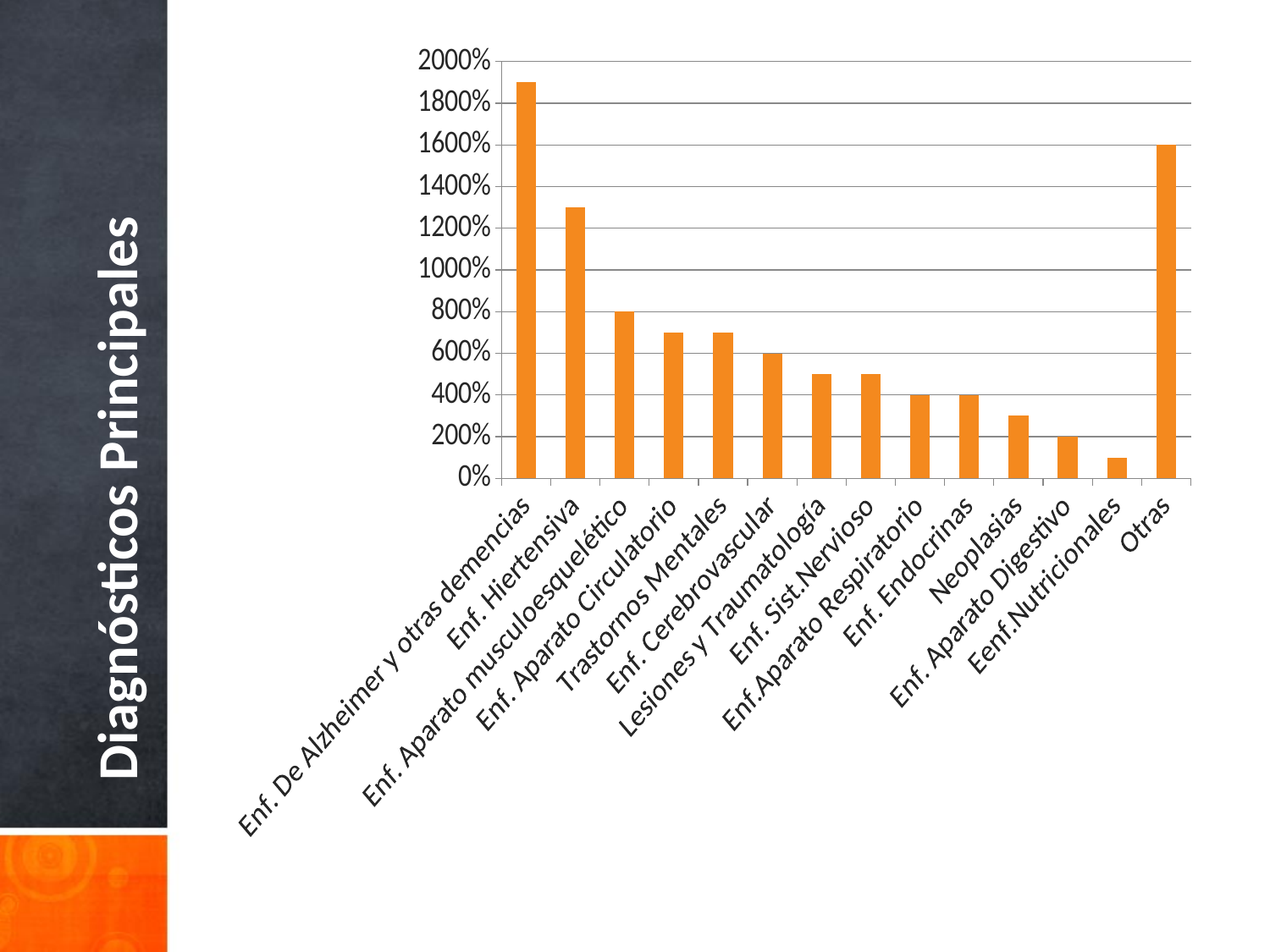
What is the difference between the values for Otras and Enf. Aparato Digestivo? 1400% What kind of chart is shown on the slide? bar chart How many categories are plotted on the x axis? 14 What is the value for Otras? 1600% Is the value for Enf. Hiertensiva greater or less than 1200%? greater What is the title of the slide containing the chart? Diagnósticos Principales What is the value for Enf. Aparato musculoesquelético? 800% What is the value for Enf. Aparato Digestivo? 200% Which is larger, the value for Enf. Hiertensiva or the value for Otras? Otras Which category has the lowest bar? Eenf.Nutricionales What is the value for Enf. Cerebrovascular? 600% Which category has the highest bar? Enf. De Alzheimer y otras demencias